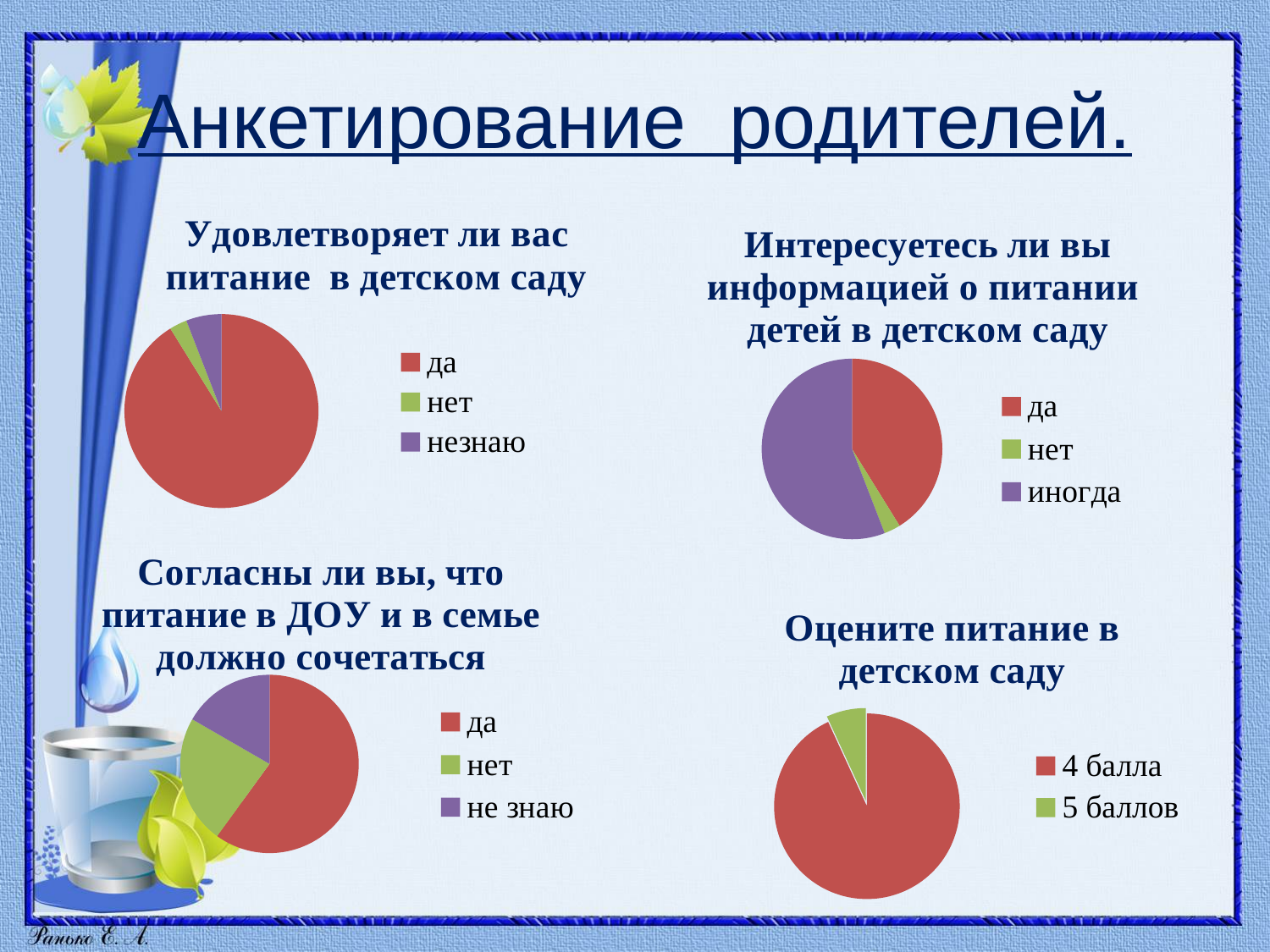
In the chart "Интересуетесь ли вы информацией о питании детей в детском саду", which category has the smallest slice? нет How many categories does the legend of the chart "Оцените питание в детском саду" list? 2 In the chart "Согласны ли вы, что питание в ДОУ и в семье должно сочетаться", which category has the smallest slice? не знаю In the chart "Удовлетворяет ли вас питание в детском саду", which category has the smallest slice? нет In the chart "Удовлетворяет ли вас питание в детском саду", which category has the largest slice? да How many categories does the legend of the chart "Удовлетворяет ли вас питание в детском саду" list? 3 What kind of chart is used for "Удовлетворяет ли вас питание в детском саду"? pie chart In the chart "Интересуетесь ли вы информацией о питании детей в детском саду", which is larger: the slice for "нет" or the slice for "иногда"? иногда What colour is the "иногда" slice in the chart "Интересуетесь ли вы информацией о питании детей в детском саду"? purple In the chart "Оцените питание в детском саду", which category has the largest slice? 4 балла In the chart "Согласны ли вы, что питание в ДОУ и в семье должно сочетаться", which is larger: the slice for "нет" or the slice for "не знаю"? нет In the chart "Согласны ли вы, что питание в ДОУ и в семье должно сочетаться", which category has the largest slice? да